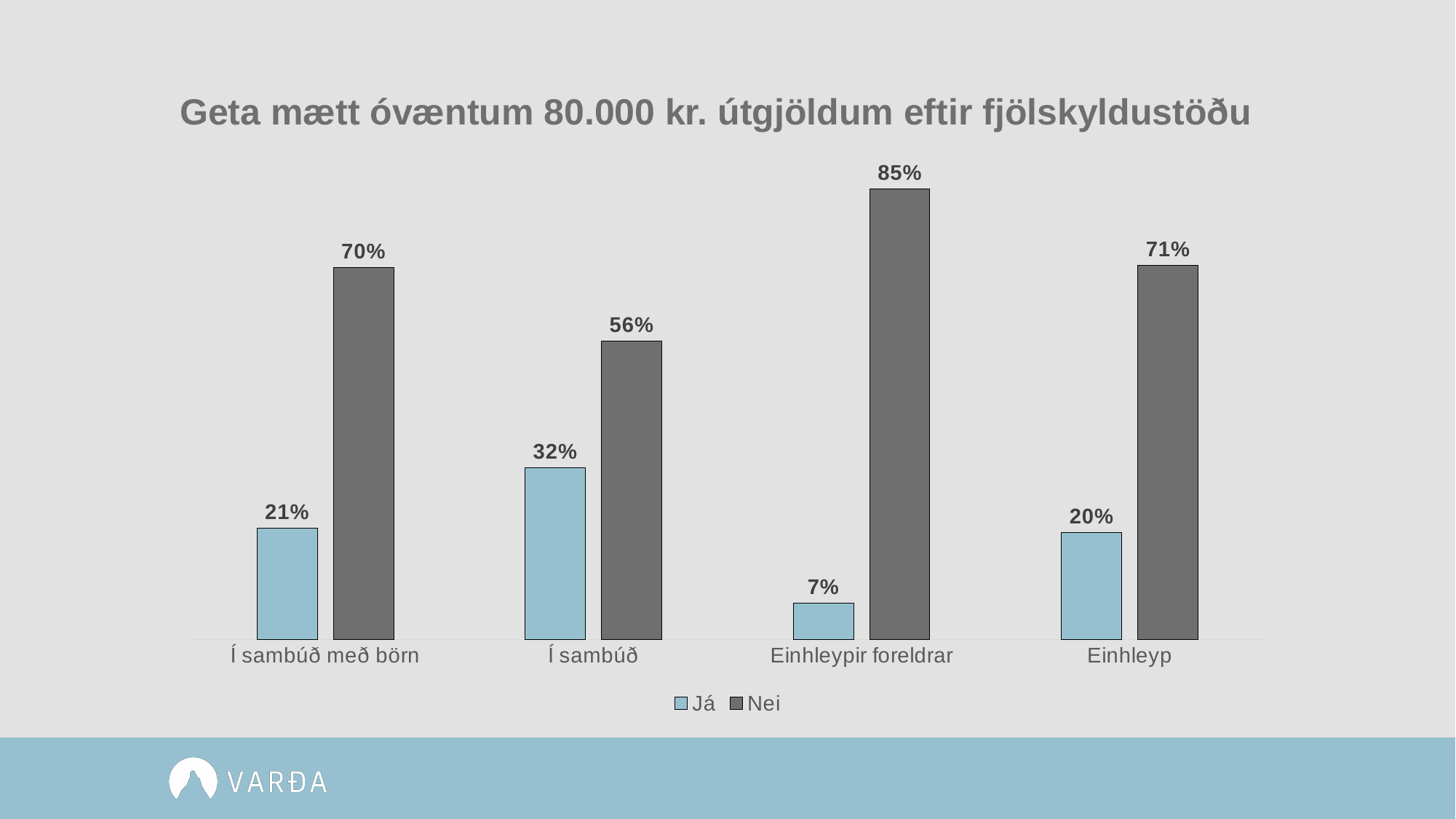
How many series does the legend list? 2 How many categories are shown on the x axis? 4 Which category has the highest 'Já' value? Í sambúð What is the difference between the 'Nei' and 'Já' values for 'Einhleypir foreldrar'? 78% What is the 'Nei' value for 'Í sambúð'? 56% What kind of chart is shown on the slide? Bar chart What is the 'Já' value for 'Í sambúð með börn'? 21% What is the 'Nei' value for 'Einhleypir foreldrar'? 85% Which category has the lowest 'Já' value? Einhleypir foreldrar Which category has the highest 'Nei' value? Einhleypir foreldrar Which is larger: the 'Nei' value for 'Í sambúð með börn' or the 'Nei' value for 'Í sambúð'? Í sambúð með börn What is the 'Já' value for 'Einhleyp'? 20%